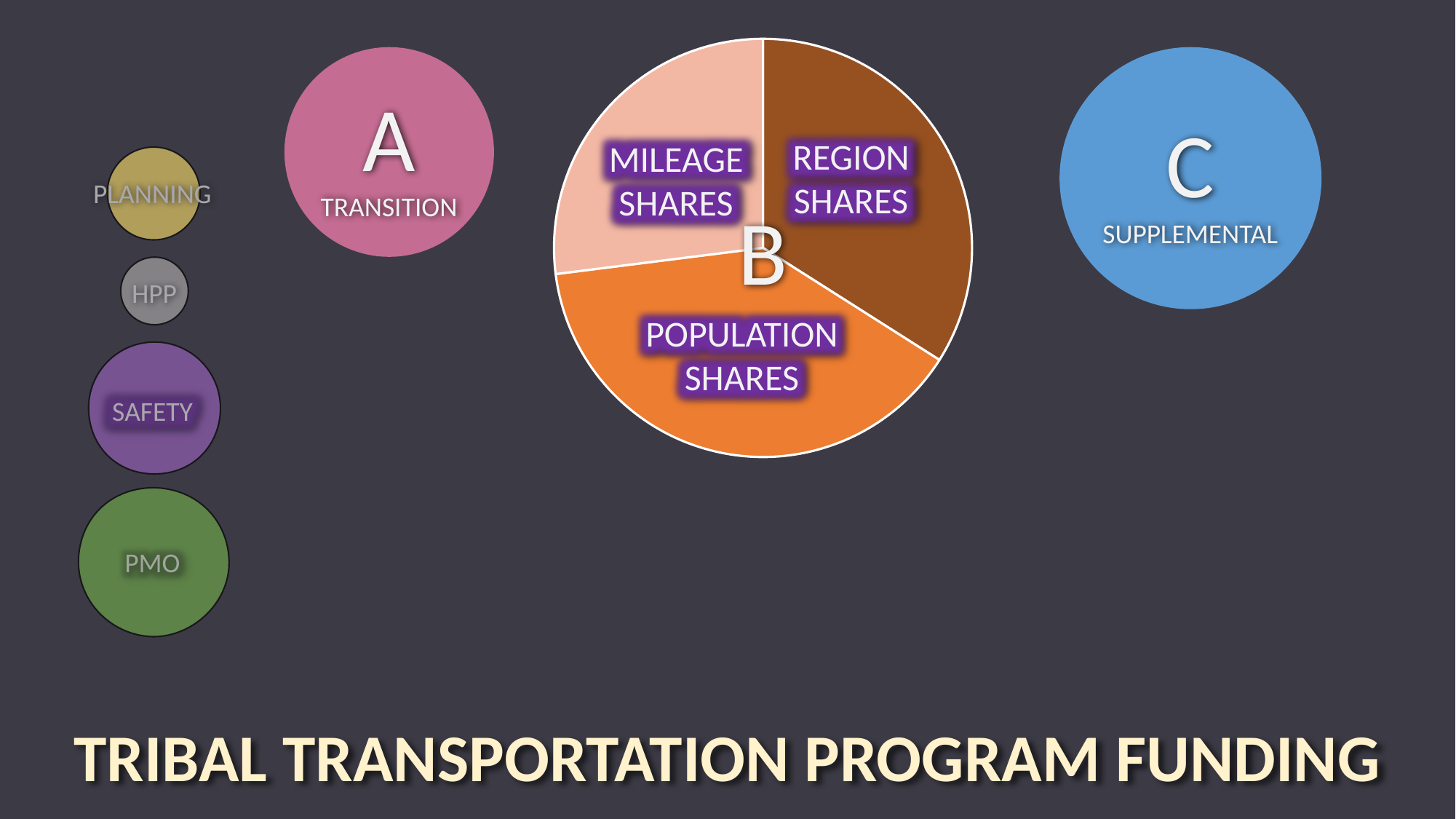
What colour is the Population Shares slice in the pie chart labelled B? orange How many slices does the pie chart labelled B have? 3 Which slice of the pie chart labelled B is the largest? Population Shares What kind of chart is the chart labelled B in the centre of the slide? pie chart In the pie chart labelled B, which slice is larger: Region Shares or Mileage Shares? Region Shares What colour is the Region Shares slice in the pie chart labelled B? brown In the pie chart labelled B, which slice is larger: Population Shares or Mileage Shares? Population Shares Which slice of the pie chart labelled B is the smallest? Mileage Shares